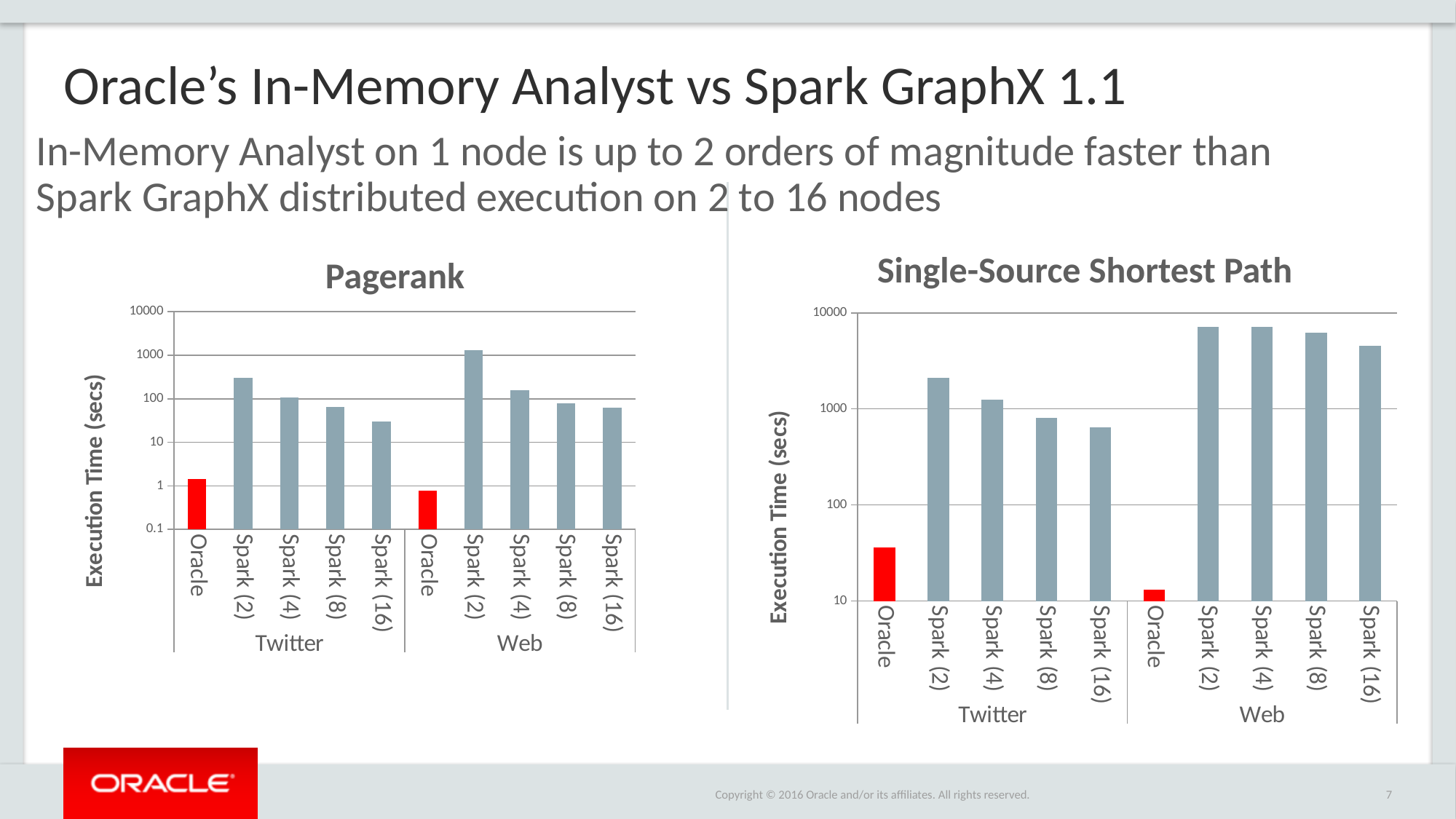
In the Single-Source Shortest Path chart, which bar has the lowest execution time? Oracle for Web In the Pagerank chart, which bar has the lowest execution time? Oracle for Web In the Single-Source Shortest Path chart, is the execution time for Oracle on Twitter greater or less than 100 secs? less In the Pagerank chart, do the Spark execution times for Twitter rise or fall as the node count goes from 2 to 16? fall In the Pagerank chart, is the execution time for Oracle on Web greater or less than 1 sec? less In the Single-Source Shortest Path chart, is the execution time for Spark (16) on Web greater or less than 1000 secs? greater What is the y-axis label on the Single-Source Shortest Path chart? Execution Time (secs) In the Pagerank chart, which bar has the highest execution time? Spark (2) for Web In the Pagerank chart, how many bars are plotted in total? 10 In the Single-Source Shortest Path chart, which has the larger execution time for Twitter: Spark (2) or Spark (16)? Spark (2) What kind of chart is the Pagerank chart? bar chart